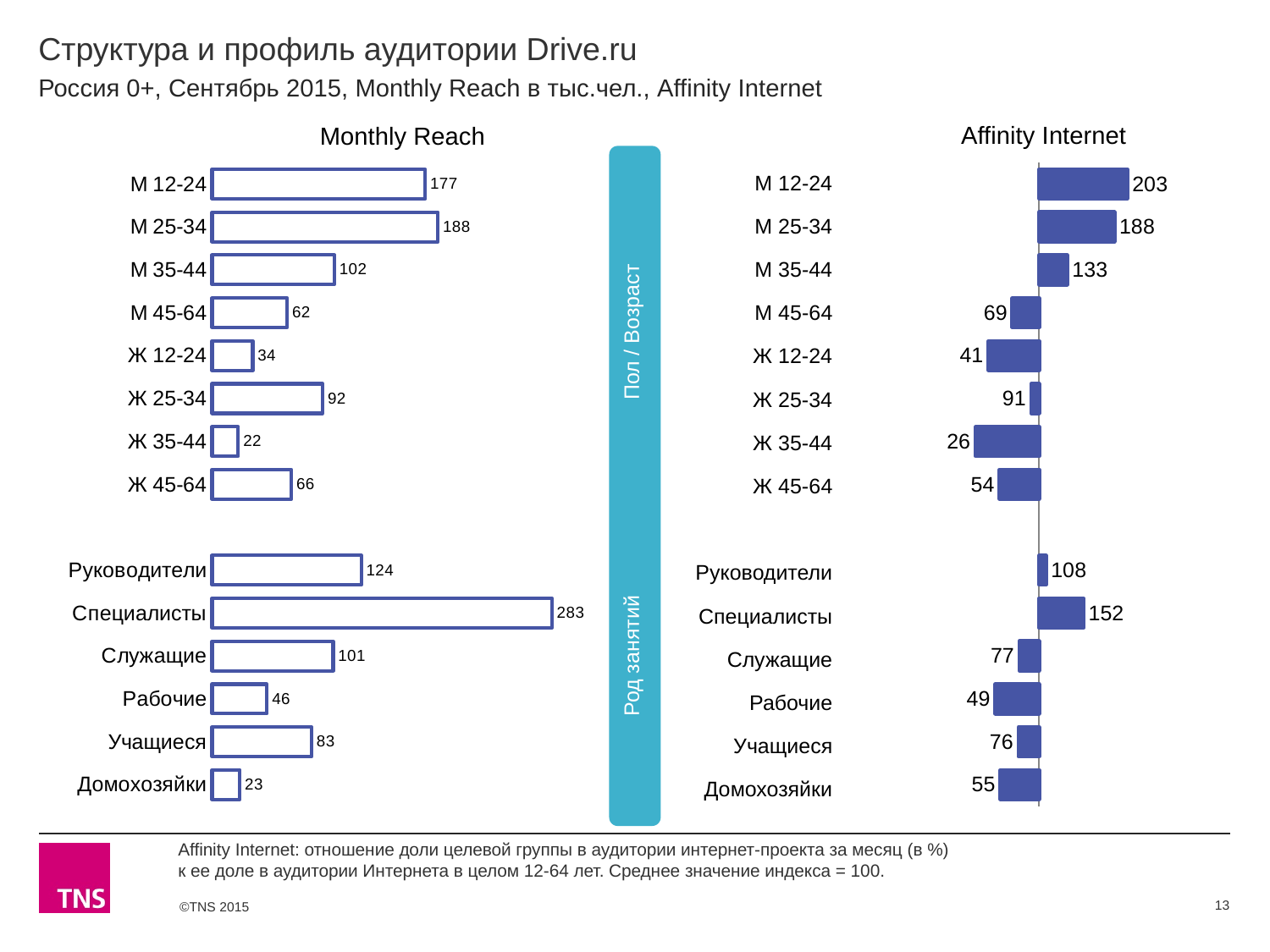
How many categories are plotted in the Monthly Reach chart? 14 In the Affinity Internet chart, which category has the lowest value? Ж 35-44 In the Affinity Internet chart, which is larger: М 12-24 or М 25-34? М 12-24 In the Monthly Reach chart, what is the value for М 25-34? 188 What are the two group labels shown on the vertical band between the charts? Пол / Возраст and Род занятий In the Monthly Reach chart, what is the difference between Специалисты and Руководители? 159 In the Monthly Reach chart, which category has the lowest value? Ж 35-44 In the Affinity Internet chart, what is the difference between Специалисты and Служащие? 75 In the Affinity Internet chart, what is the value for Ж 35-44? 26 What kind of chart is the Affinity Internet chart? Bar chart In the Monthly Reach chart, what is the value for Домохозяйки? 23 In the Monthly Reach chart, which category has the highest value? Специалисты